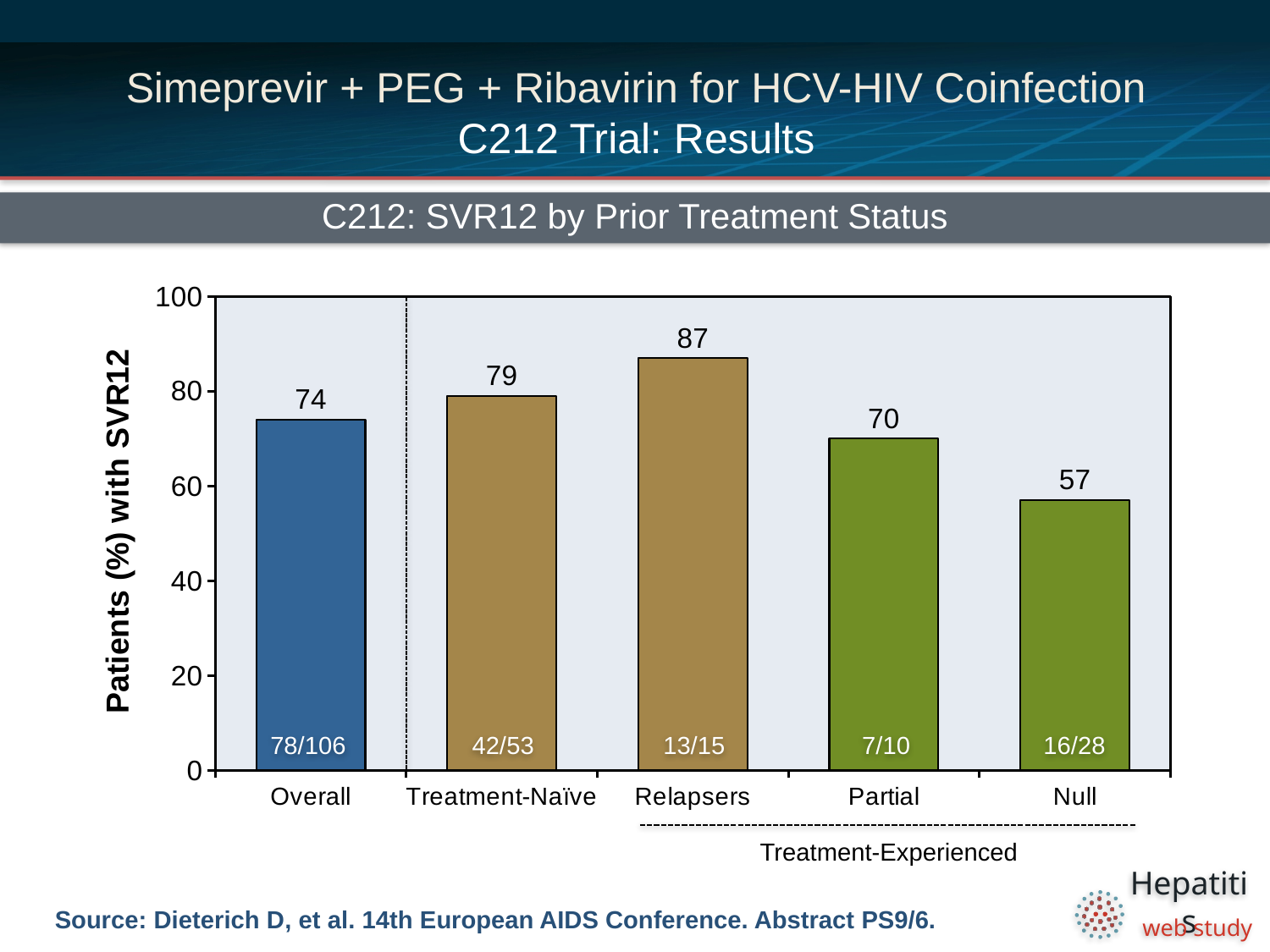
What is the SVR12 rate (%) for the Overall group? 74 How many categories are plotted on the chart? 5 Do the SVR12 values rise or fall from Relapsers to Null along the x axis? Fall What kind of chart is shown? Bar chart What is the difference in SVR12 rate between Relapsers and Null? 30 What is the SVR12 rate (%) for the Null group? 57 What is the SVR12 rate (%) for Relapsers? 87 What fraction of patients is shown inside the Treatment-Naïve bar? 42/53 Which has a higher SVR12 rate, Treatment-Naïve or Partial? Treatment-Naïve Which category has the highest SVR12 rate? Relapsers Which category has the lowest SVR12 rate? Null What is the title of the chart? C212: SVR12 by Prior Treatment Status